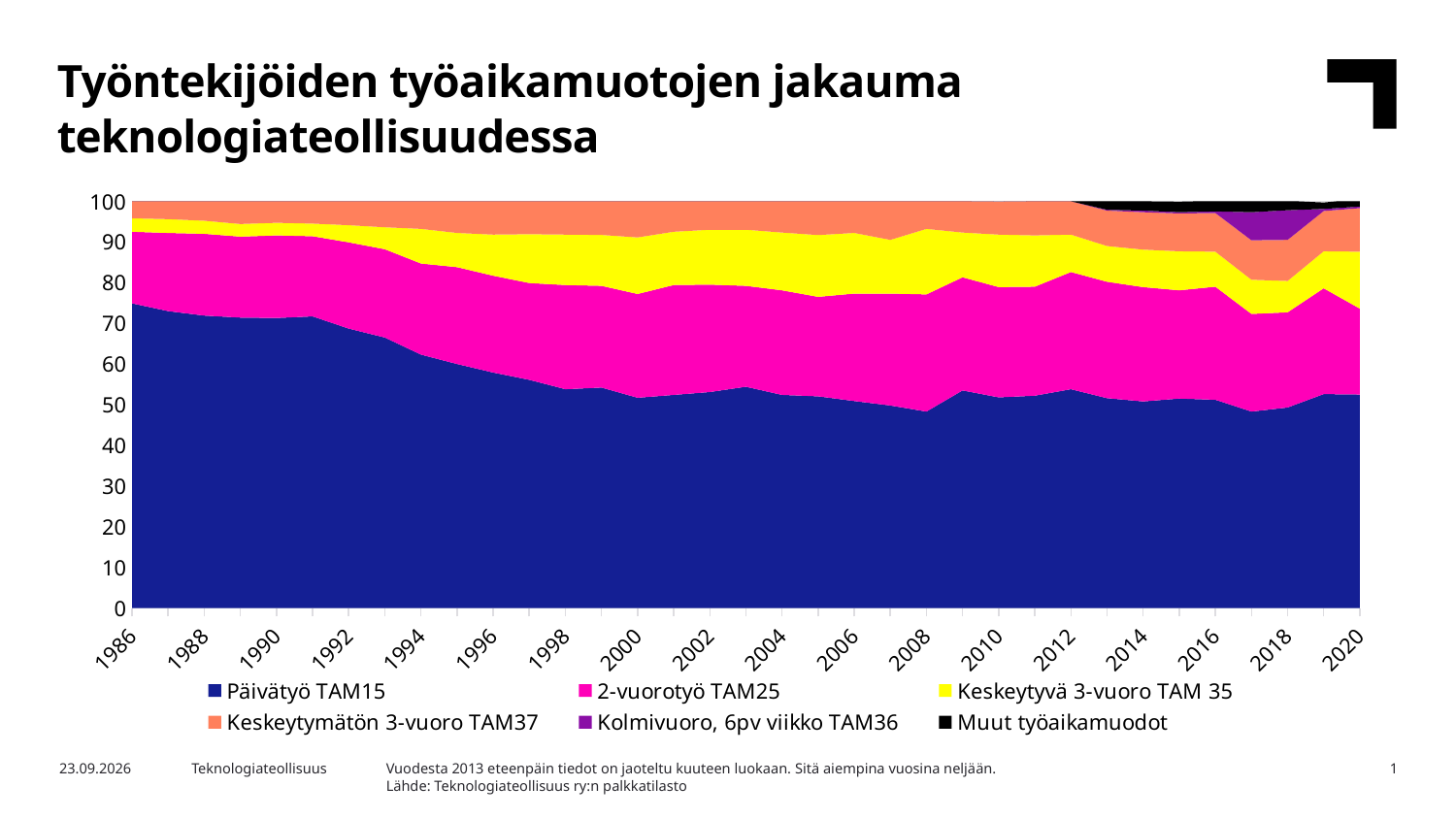
Is the value for Päivätyö TAM15 in 1986 greater or less than 70? greater Which series occupies the largest share of the chart throughout the period? Päivätyö TAM15 Is the value for Päivätyö TAM15 in 1998 greater or less than 60? less Is the value for Päivätyö TAM15 in 2020 greater or less than 60? less How many year labels are shown on the x axis? 18 What is the first year shown on the x axis? 1986 What is the highest value shown on the y axis? 100 What is the last year shown on the x axis? 2020 What kind of chart is shown on the slide? Area chart How many series does the legend list? 6 Does the share of Päivätyö TAM15 rise or fall from 1986 to 2020? fall What is the title of the chart? Työntekijöiden työaikamuotojen jakauma teknologiateollisuudessa